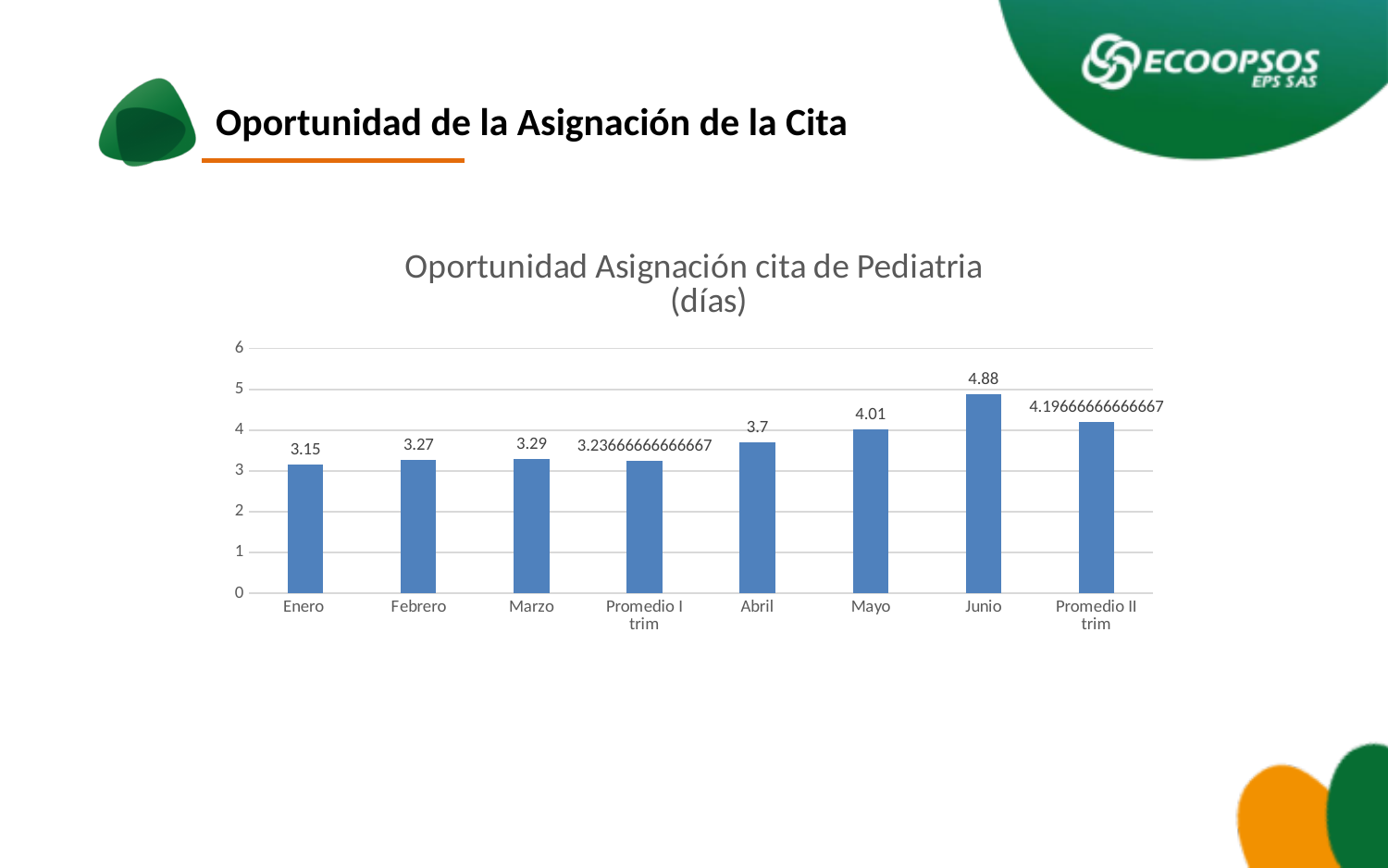
Which is larger, the value for Abril or the value for Marzo? Abril What is the value for Promedio I trim? 3.23666666666667 Which category has the highest value? Junio What is the title of the chart? Oportunidad Asignación cita de Pediatria (días) What is the value for Promedio II trim? 4.19666666666667 What is the value for Junio? 4.88 Which category has the lowest value? Enero What is the difference between the values for Junio and Mayo? 0.87 What kind of chart is shown? Bar chart What is the value for Enero? 3.15 How many categories are shown on the x axis? 8 Is the value for Mayo greater or less than 4? greater